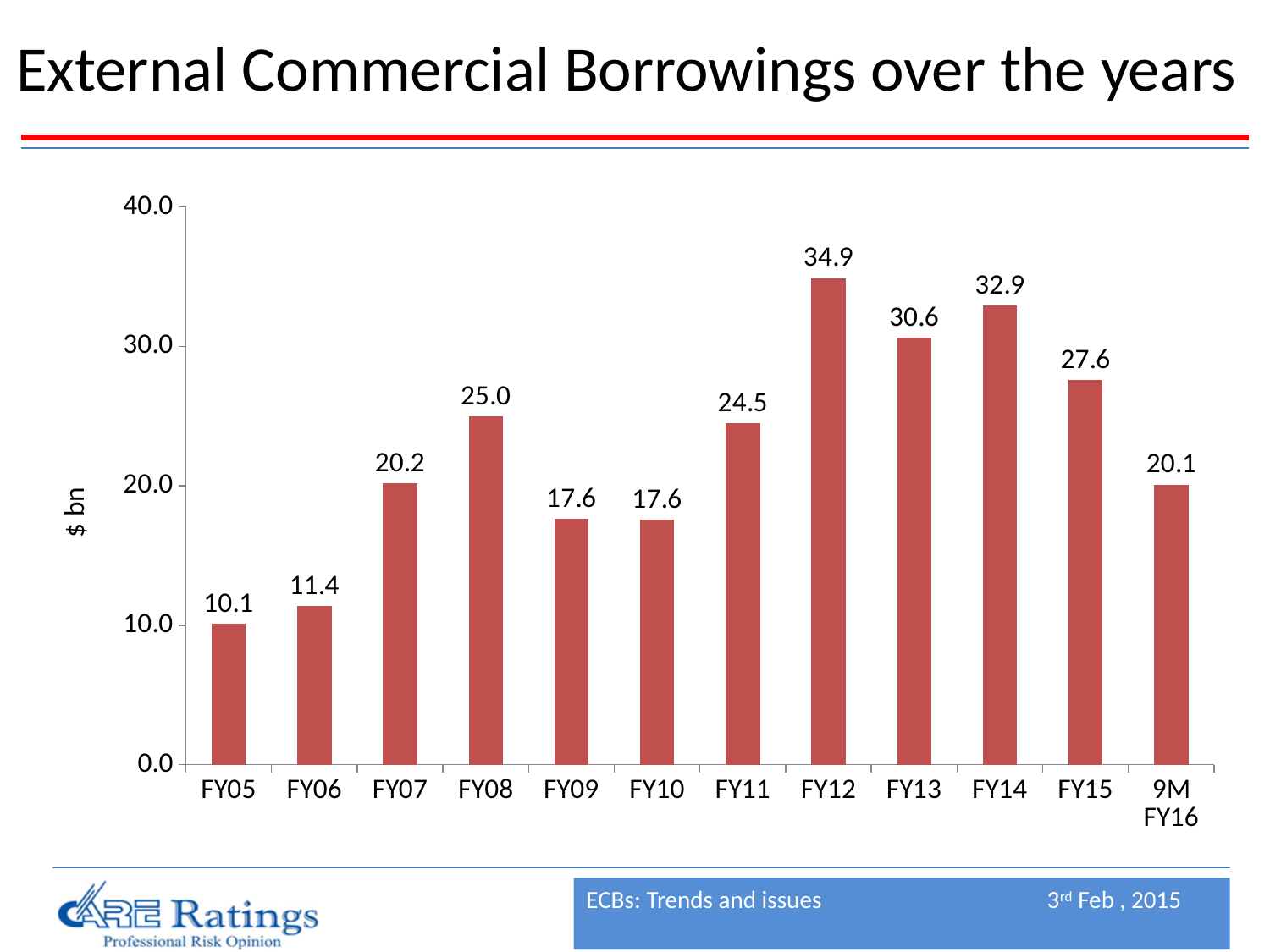
What is the value for 9M FY16? 20.1 Which year has the highest value? FY12 What is the value for FY05? 10.1 What kind of chart is shown on the slide? bar chart Which is larger, the value for FY08 or the value for FY11? FY08 How many bars are shown in the chart? 12 Which year has the lowest value? FY05 Is the value for FY13 greater or less than 30.0? greater What is the label on the vertical axis? $ bn What is the value for FY12? 34.9 What is the difference between the values for FY14 and FY15? 5.3